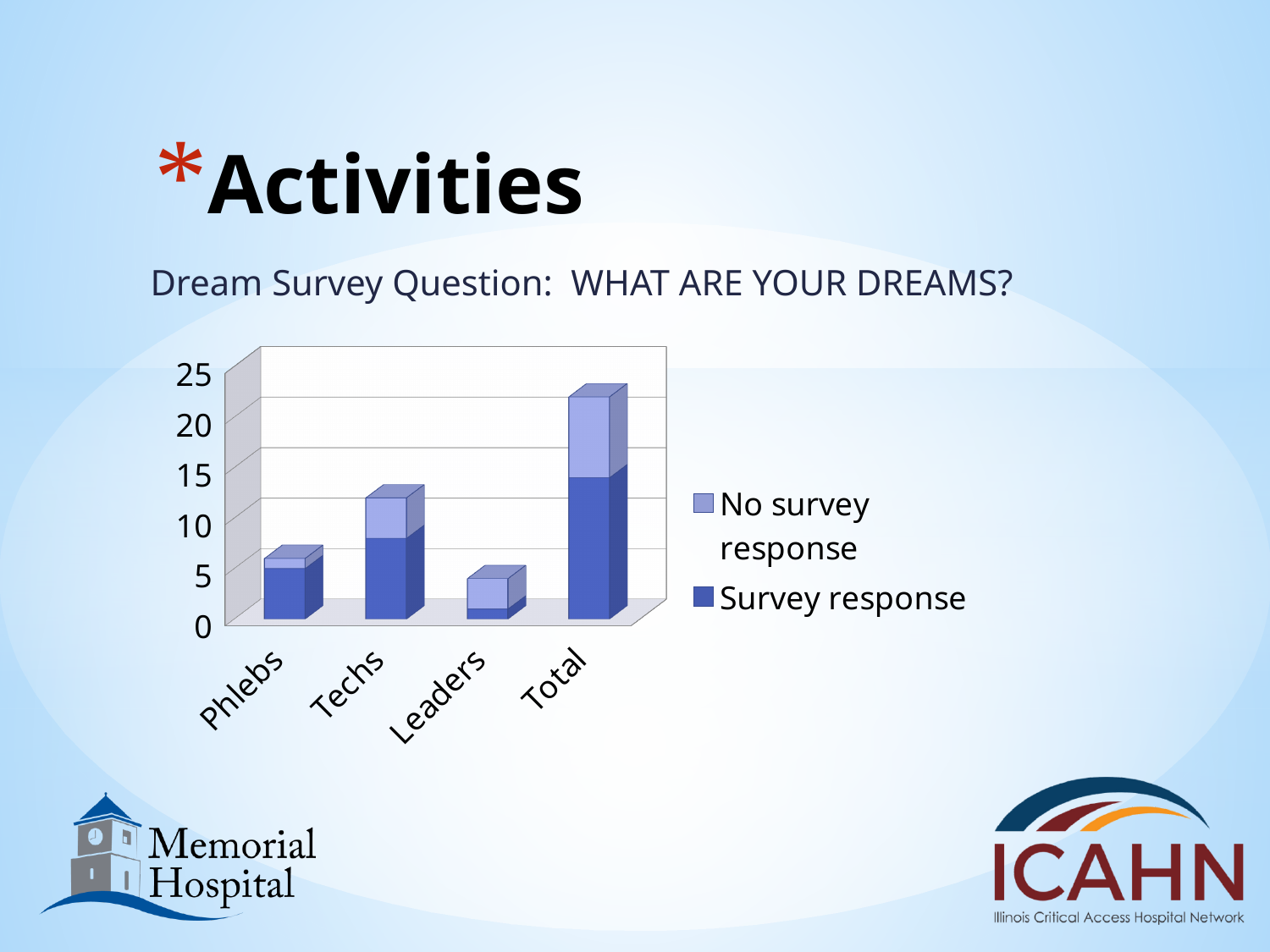
What are the two legend entries of the chart? No survey response; Survey response Which category has the tallest stacked bar? Total What is the highest value shown on the chart's vertical axis? 25 Which stacked bar is taller, Techs or Phlebs? Techs Is the total height of the Total bar greater or less than 20? greater Is the total height of the Techs bar greater or less than 10? greater Is the total height of the Phlebs bar greater or less than 10? less Which category has the shortest stacked bar? Leaders How many categories are shown on the x axis of the chart? 4 What kind of chart is shown on the slide? Stacked bar chart How many series does the chart's legend list? 2